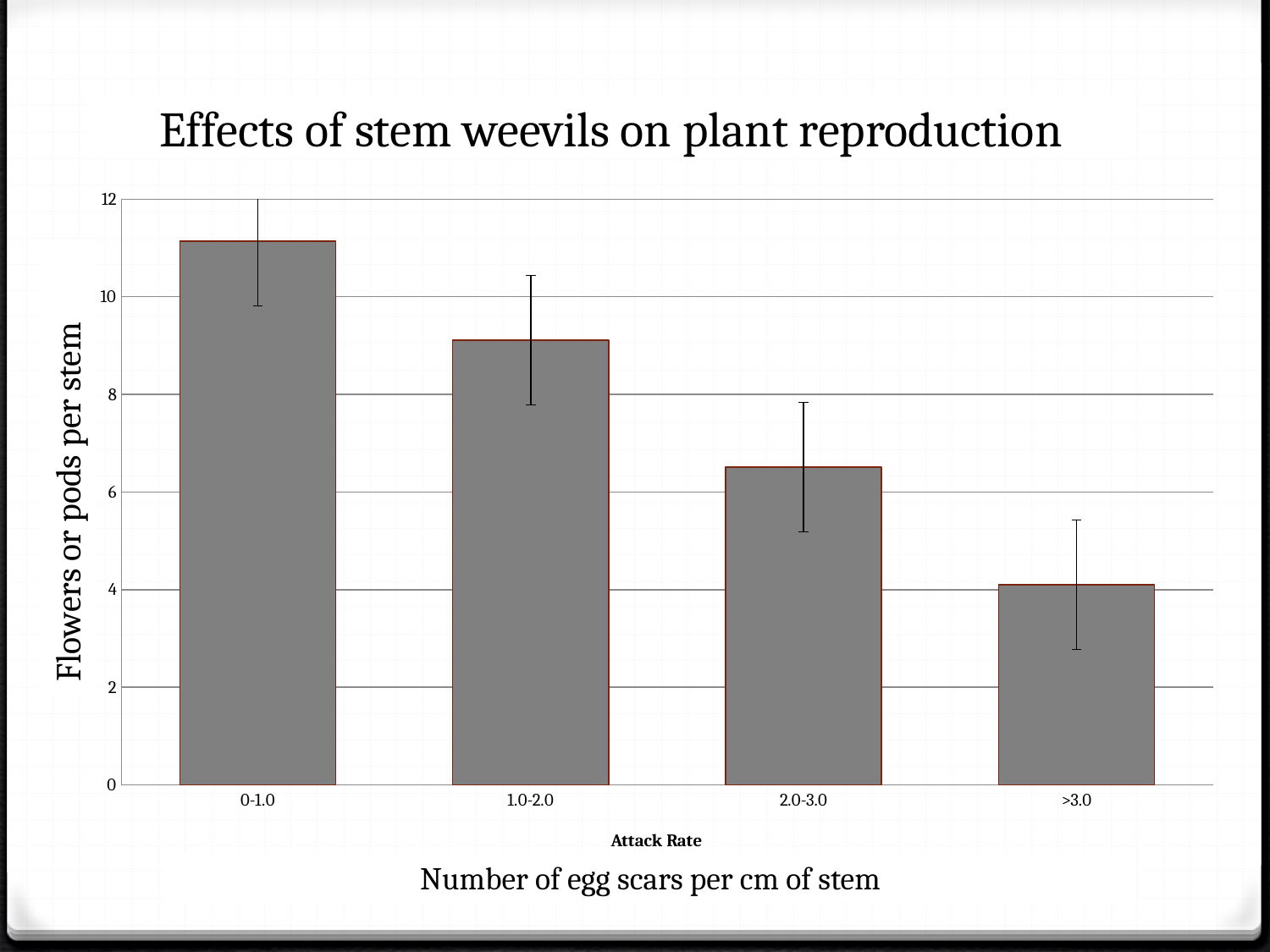
Do the values rise or fall as the attack rate increases along the x axis? fall Which has more flowers or pods per stem, the 1.0-2.0 category or the 2.0-3.0 category? 1.0-2.0 Is the value for the 0-1.0 category greater or less than 10? greater Is the value for the 2.0-3.0 category greater or less than 8? less How many attack rate categories are shown on the x axis? 4 Is the value for the 1.0-2.0 category greater or less than 8? greater What is the title of the chart? Effects of stem weevils on plant reproduction What kind of chart is shown on the slide? bar chart What is the label of the y axis? Flowers or pods per stem Which attack rate category has the highest number of flowers or pods per stem? 0-1.0 Which attack rate category has the lowest number of flowers or pods per stem? >3.0